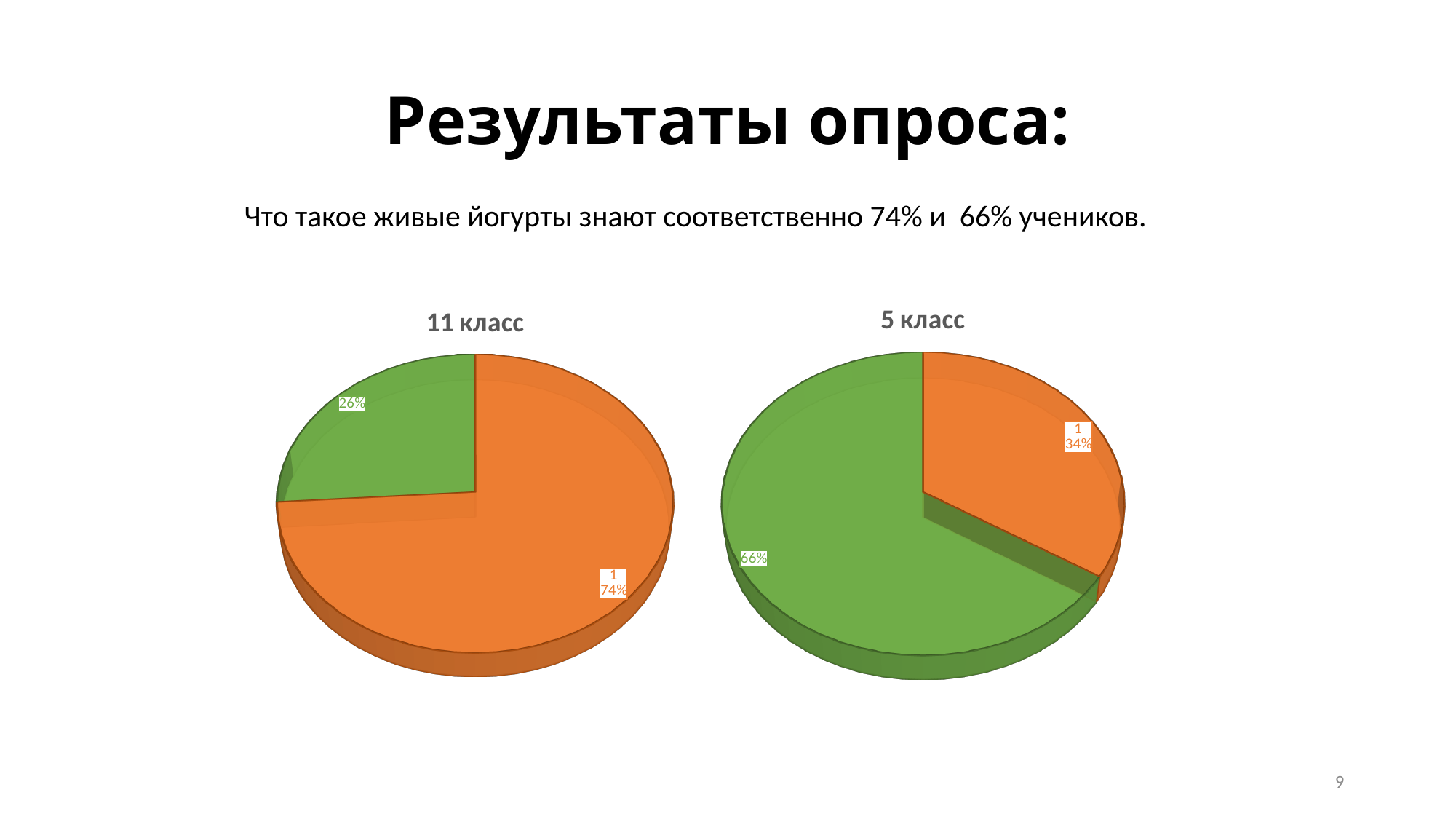
In the "5 класс" chart, what is the difference between the green and orange slices? 32% In the "5 класс" chart, what share does the orange slice have? 34% Which is larger: the orange slice in the "11 класс" chart or the orange slice in the "5 класс" chart? the orange slice in the "11 класс" chart How many slices does the "5 класс" pie chart have? 2 In the "5 класс" chart, what share does the green slice have? 66% What kind of chart is the "11 класс" chart? pie chart In the "5 класс" chart, which slice is the smallest? the orange slice (34%) In the "11 класс" chart, what share does the orange slice have? 74% In the "11 класс" chart, which slice is the largest? the orange slice (74%) What kind of chart is the "5 класс" chart? pie chart In the "11 класс" chart, what is the difference between the orange and green slices? 48%